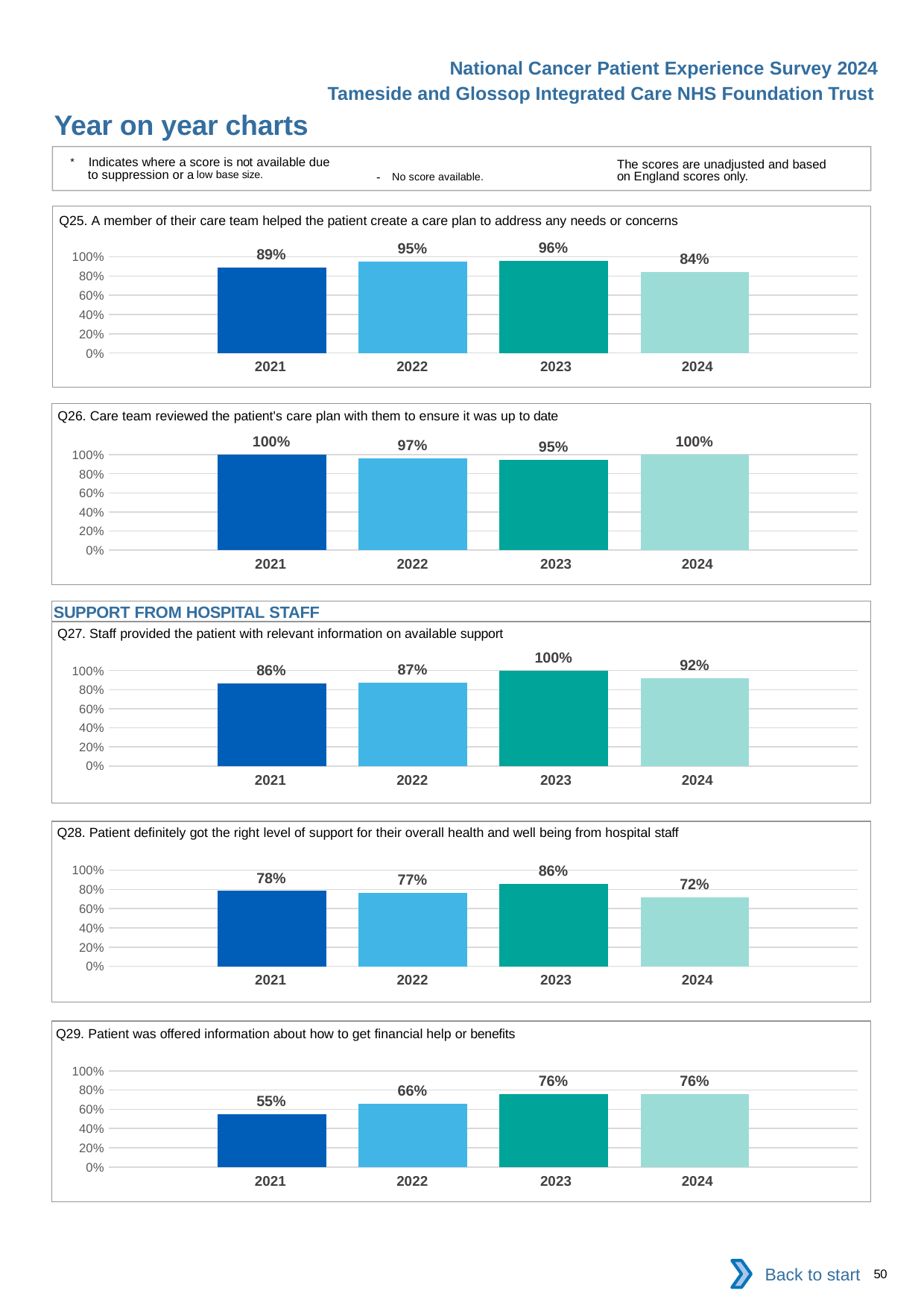
In the Q28 chart, what is the difference between the 2023 and 2024 values? 14% In the Q28 chart, which is larger, the value for 2021 or the value for 2024? 2021 What type of chart is the Q25 chart? bar chart In the Q27 chart, which year has the highest value? 2023 In the Q26 chart, what is the value for 2022? 97% In the Q25 chart, what is the value for 2023? 96% In the Q27 chart, what is the value for 2024? 92% In the Q29 chart, do the values rise or fall from 2021 to 2023? rise In the Q25 chart, which year has the lowest value? 2024 In the Q29 chart, what is the value for 2021? 55% In the Q26 chart, what is the difference between the 2021 and 2023 values? 5% How many years are shown on the x axis of the Q29 chart? 4